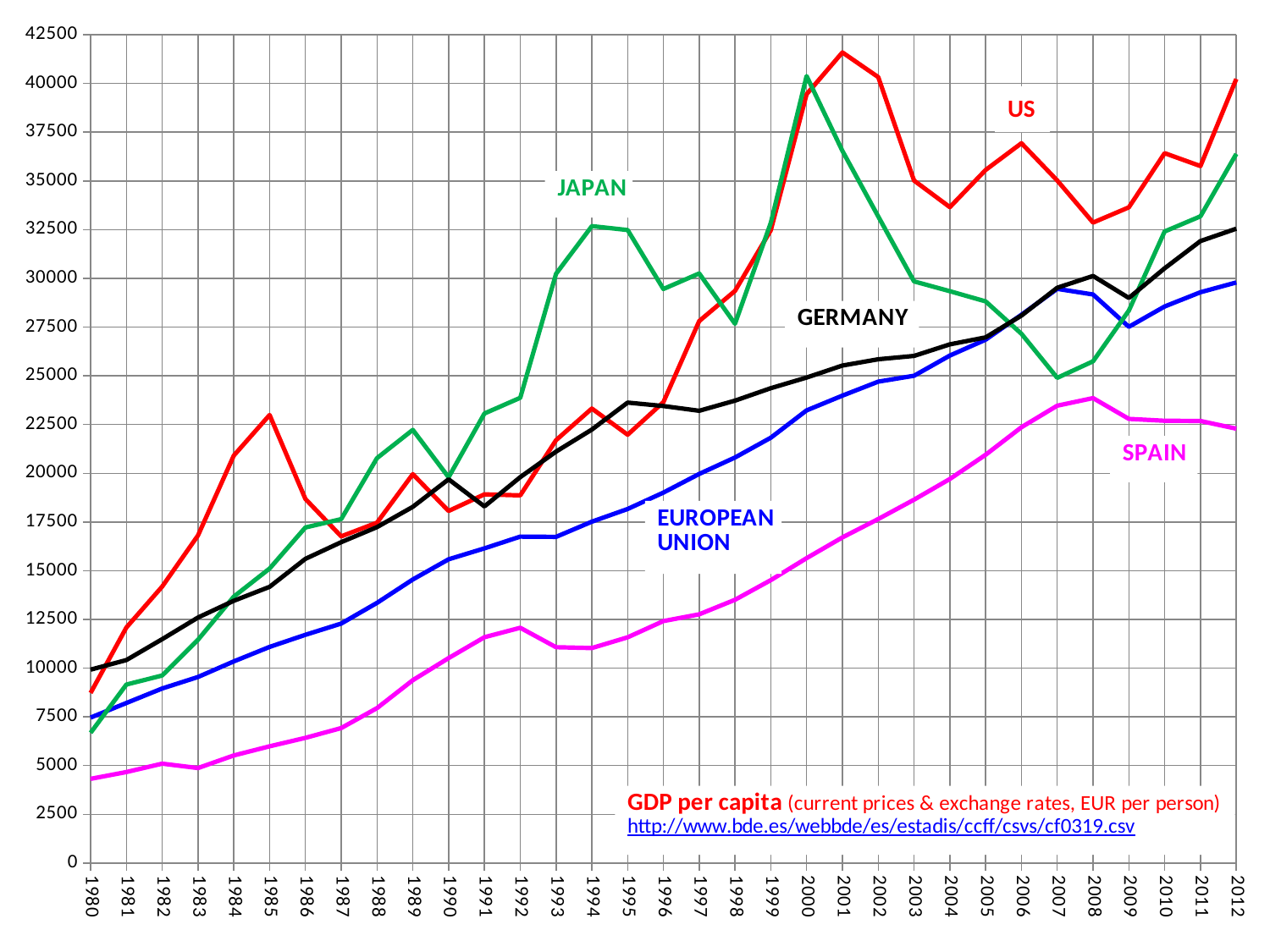
Is the value for Spain in 2012 greater or less than 25000? less Is the value for Spain in 1980 greater or less than 5000? less Is the value for the US in 2001 greater or less than 40000? greater Which series has the highest value in 2012? US What kind of chart is shown on the slide? line chart Does the value for Spain rise or fall from 2008 to 2012? fall How many series (countries/regions) are plotted on the chart? 5 In 1995, which is larger: the value for Japan or the value for the US? Japan Which series has the highest value in 1985? US Which series has the lowest value in 2012? Spain How many years are shown along the x axis of the chart? 33